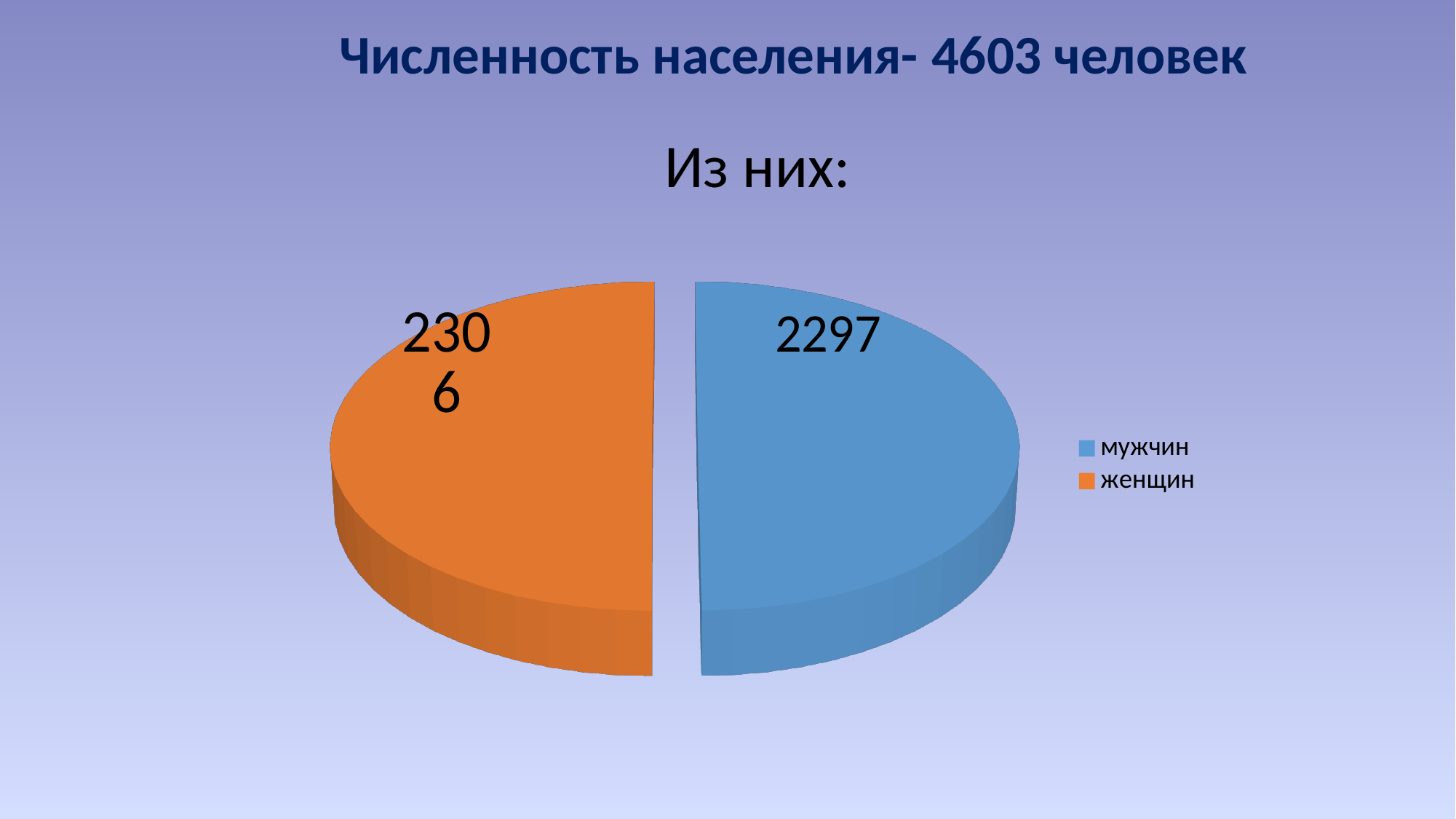
How many entries does the legend list? 2 Which colour represents мужчин in the pie chart? blue What is the value for женщин in the pie chart? 2306 Which category has the larger value in the pie chart, мужчин or женщин? женщин Which category has the smallest value in the pie chart? мужчин What is the title at the top of the slide? Численность населения- 4603 человек What is the value for мужчин in the pie chart? 2297 What is the total of the two slices in the pie chart? 4603 What is the difference between the values for женщин and мужчин? 9 How many slices does the pie chart have? 2 What kind of chart is shown on the slide? pie chart